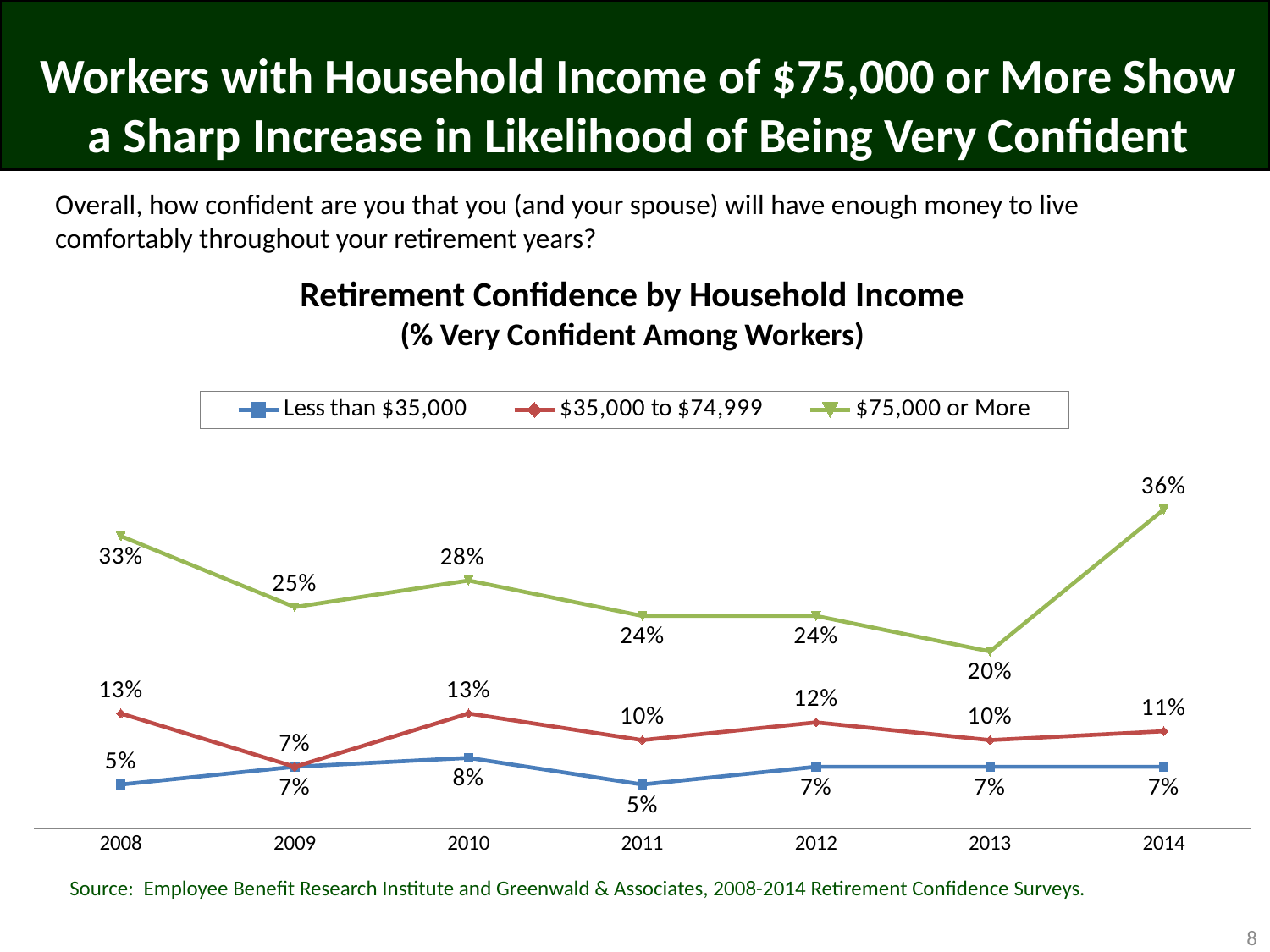
In which year is the $75,000 or More series at its lowest? 2013 In which year is the $75,000 or More series at its highest? 2014 What is the value for $35,000 to $74,999 in 2012? 12% Does the $75,000 or More series rise or fall from 2013 to 2014? Rise Which series has the larger value in 2008: $35,000 to $74,999 or Less than $35,000? $35,000 to $74,999 What type of chart is shown on the slide? Line chart What is the difference between the $75,000 or More value in 2014 and in 2013? 16 percentage points What is the value for $75,000 or More in 2014? 36% How many series does the legend list? 3 What is the title of the chart? Retirement Confidence by Household Income (% Very Confident Among Workers) What is the value for Less than $35,000 in 2010? 8% How many years are plotted along the x axis? 7